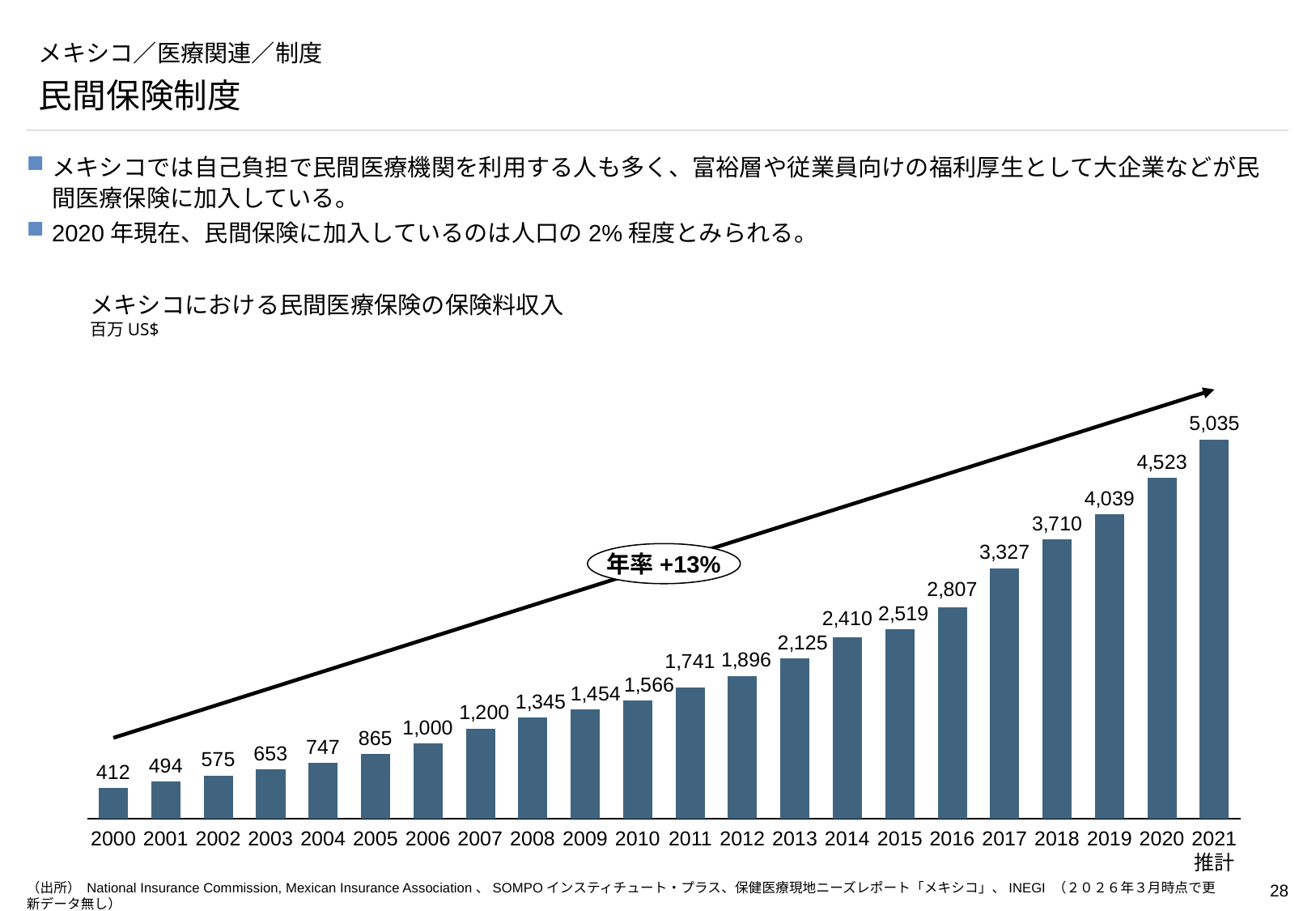
What is the premium income value shown for 2010? 1,566 Which year has the highest value in the chart? 2021 Which is larger, the value for 2014 or the value for 2015? 2015 What kind of chart is shown on the slide? Bar chart How many years (bars) are shown in the chart? 22 Do the values rise or fall from 2000 to 2021? Rise What annual growth rate is labelled on the arrow in the chart? 年率 +13% What is the value shown for 2017? 3,327 What is the difference between the values for 2021 and 2020? 512 What is the difference between the values for 2006 and 2005? 135 What is the value shown for 2000? 412 Which year has the lowest value in the chart? 2000